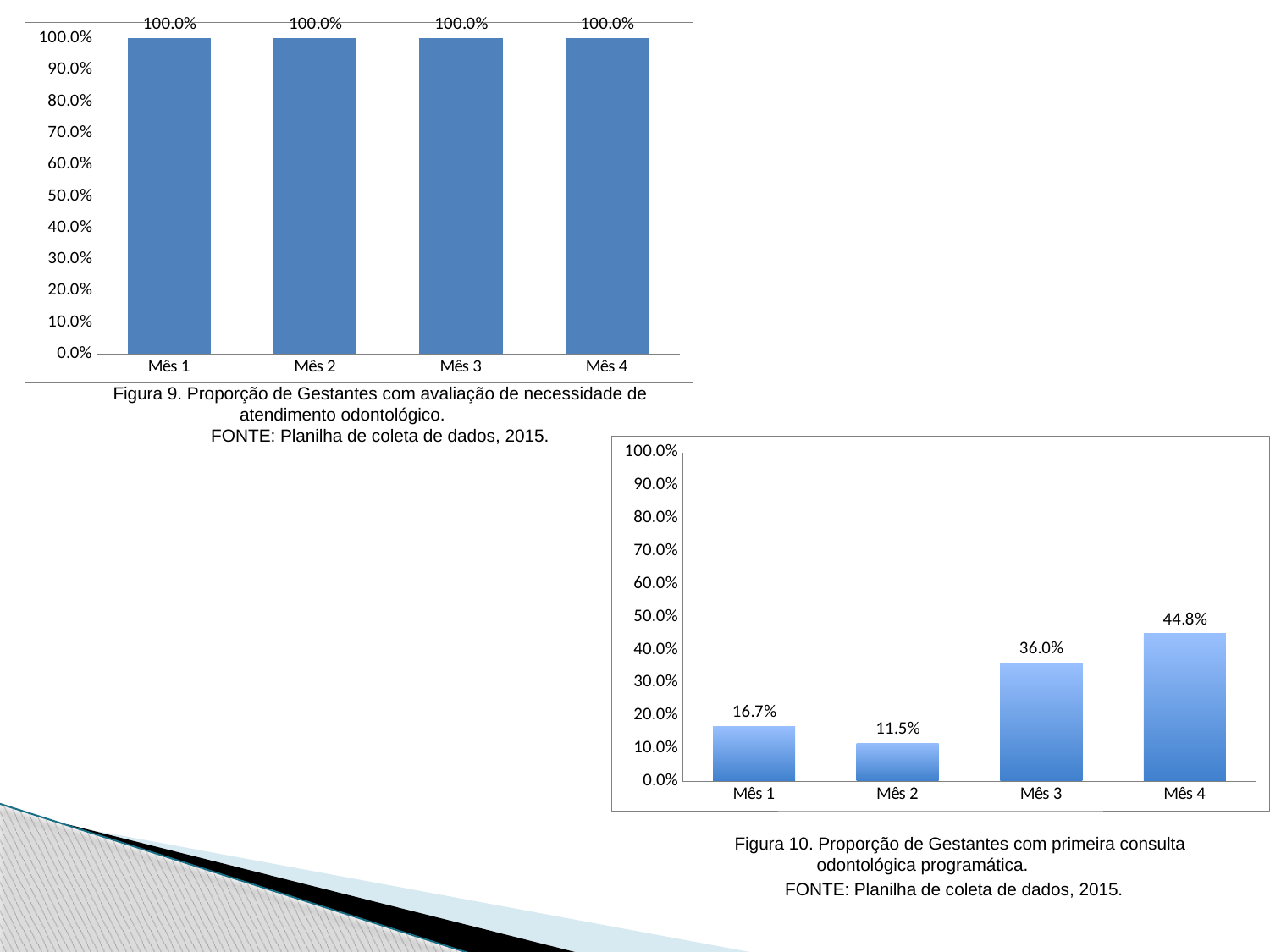
In the Figura 10 chart (bottom right), which is larger, the value for Mês 1 or Mês 2? Mês 1 What kind of chart is the Figura 10 chart (bottom right)? Bar chart In the Figura 9 chart (top left), what is the value for Mês 2? 100.0% In the Figura 10 chart (bottom right), which month has the highest value? Mês 4 In the Figura 10 chart (bottom right), what is the difference between the values for Mês 4 and Mês 3? 8.8% In the Figura 10 chart (bottom right), which month has the lowest value? Mês 2 In the Figura 9 chart (top left), do the values change from Mês 1 to Mês 4? No, they stay at 100.0% In the Figura 10 chart (bottom right), is the value for Mês 4 greater or less than 40.0%? greater In the Figura 10 chart (bottom right), what is the value for Mês 1? 16.7% In the Figura 10 chart (bottom right), what is the value for Mês 3? 36.0% How many categories are shown in the Figura 9 chart (top left)? 4 What is the source (FONTE) cited below the Figura 10 chart? Planilha de coleta de dados, 2015.